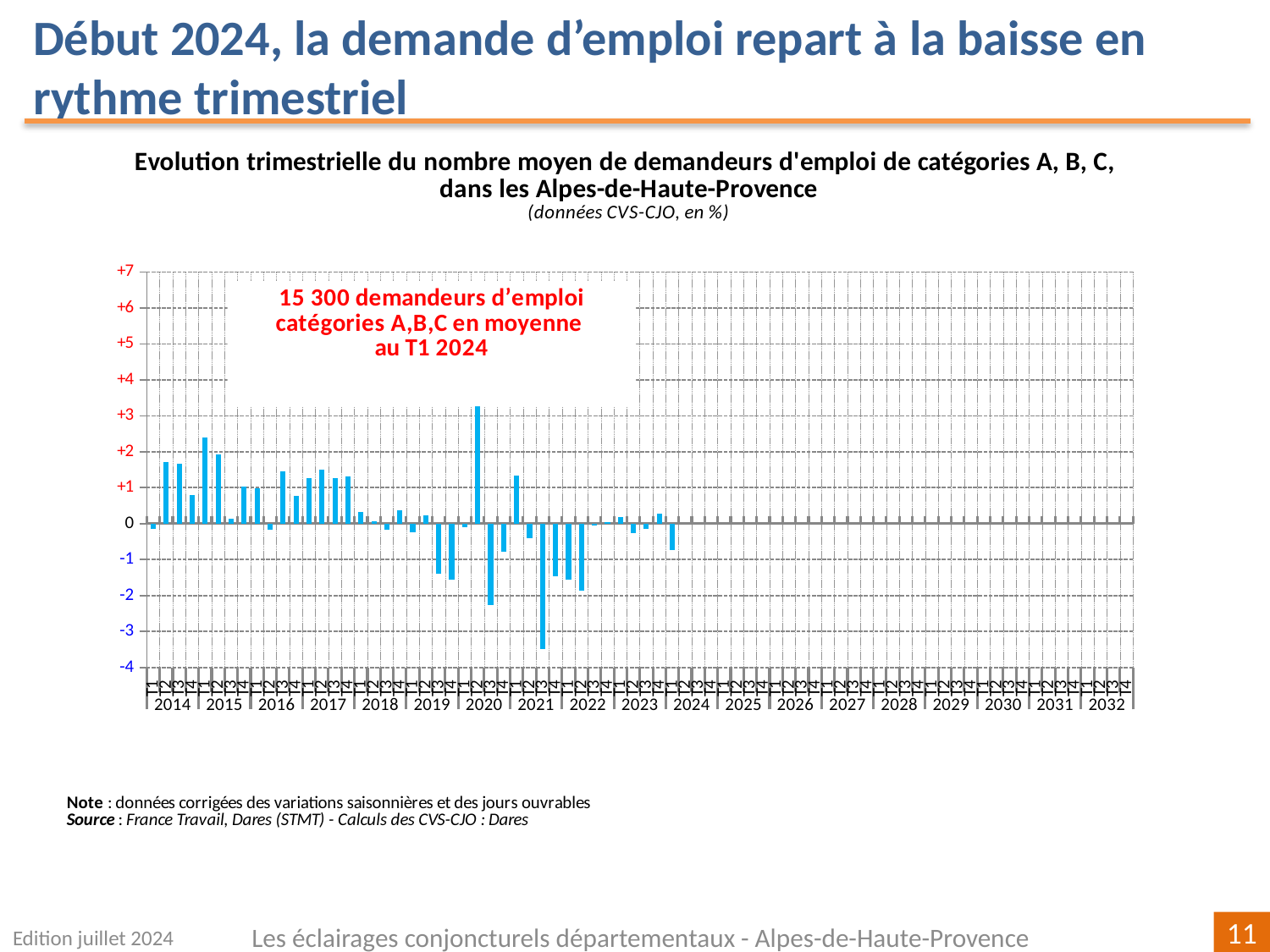
In which quarter does the chart show its highest value? T2 2020 Which is larger, the value for T2 2020 or the value for T1 2015? T2 2020 What is the highest tick value shown on the vertical axis? +7 Is the value for T1 2024 greater or less than 0? less Is the value for T1 2015 greater or less than +2? greater According to the annotation on the chart, how many job seekers in categories A, B, C were there on average in T1 2024? 15 300 What kind of chart is shown on the slide? Bar chart Which is larger, the value for T1 2015 or the value for T1 2014? T1 2015 In which quarter does the chart show its lowest value? T3 2021 Is the value for T2 2021 greater or less than -3? greater